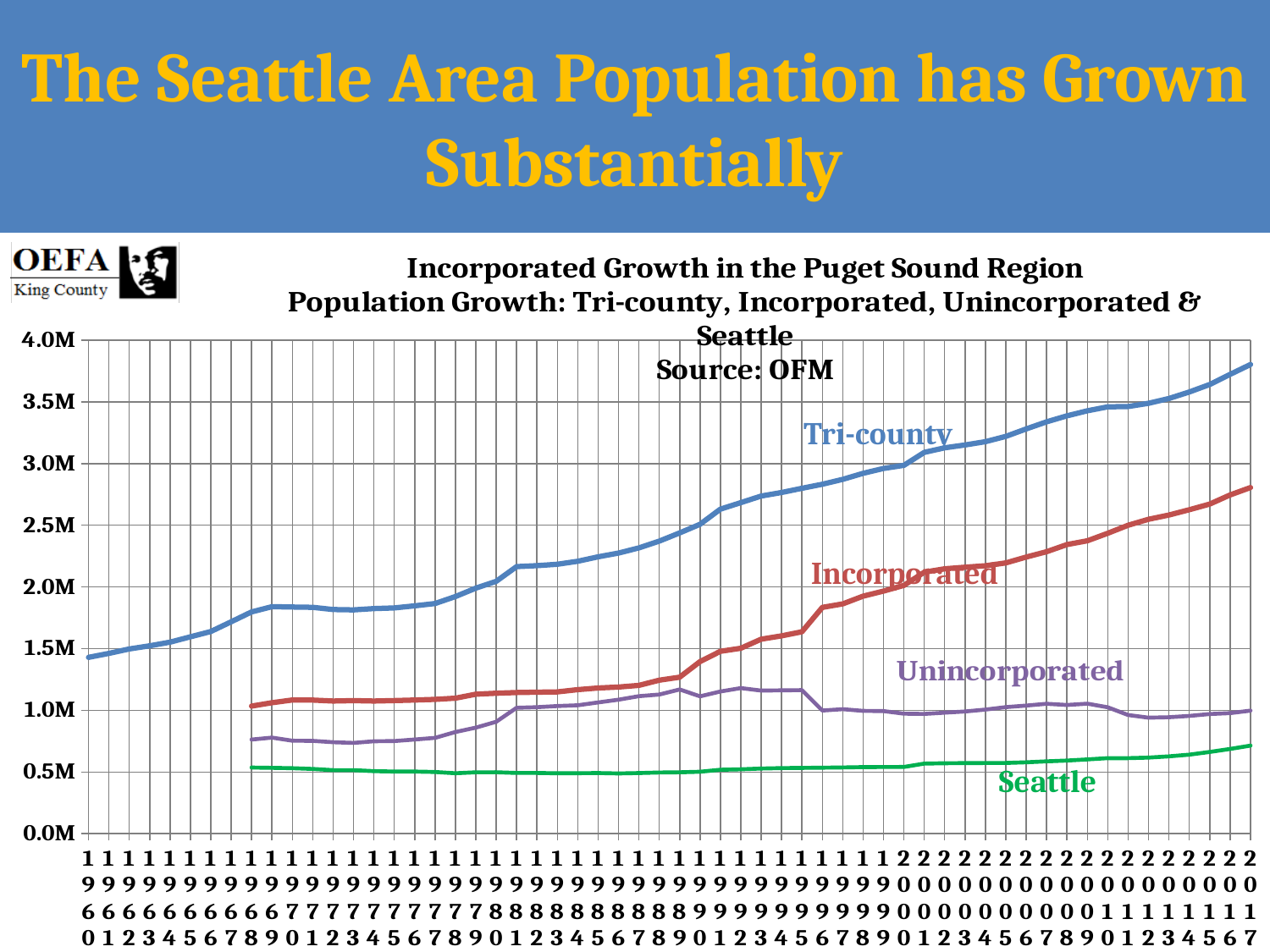
What kind of chart is shown on the slide? line chart What is the highest value shown on the y axis? 4.0M Which series has the lowest values throughout the chart? Seattle Is the Seattle value for 2017 greater or less than 1.0M? less Does the Tri-county population rise or fall from 1960 to 2017? rise In 2017, which is larger, the Incorporated value or the Unincorporated value? Incorporated How many series are plotted on the chart? 4 Is the Tri-county value for 2017 greater or less than 3.5M? greater Is the Tri-county value for 1960 greater or less than 1.5M? less Which series has the highest values throughout the chart? Tri-county What is the source cited in the chart title? OFM